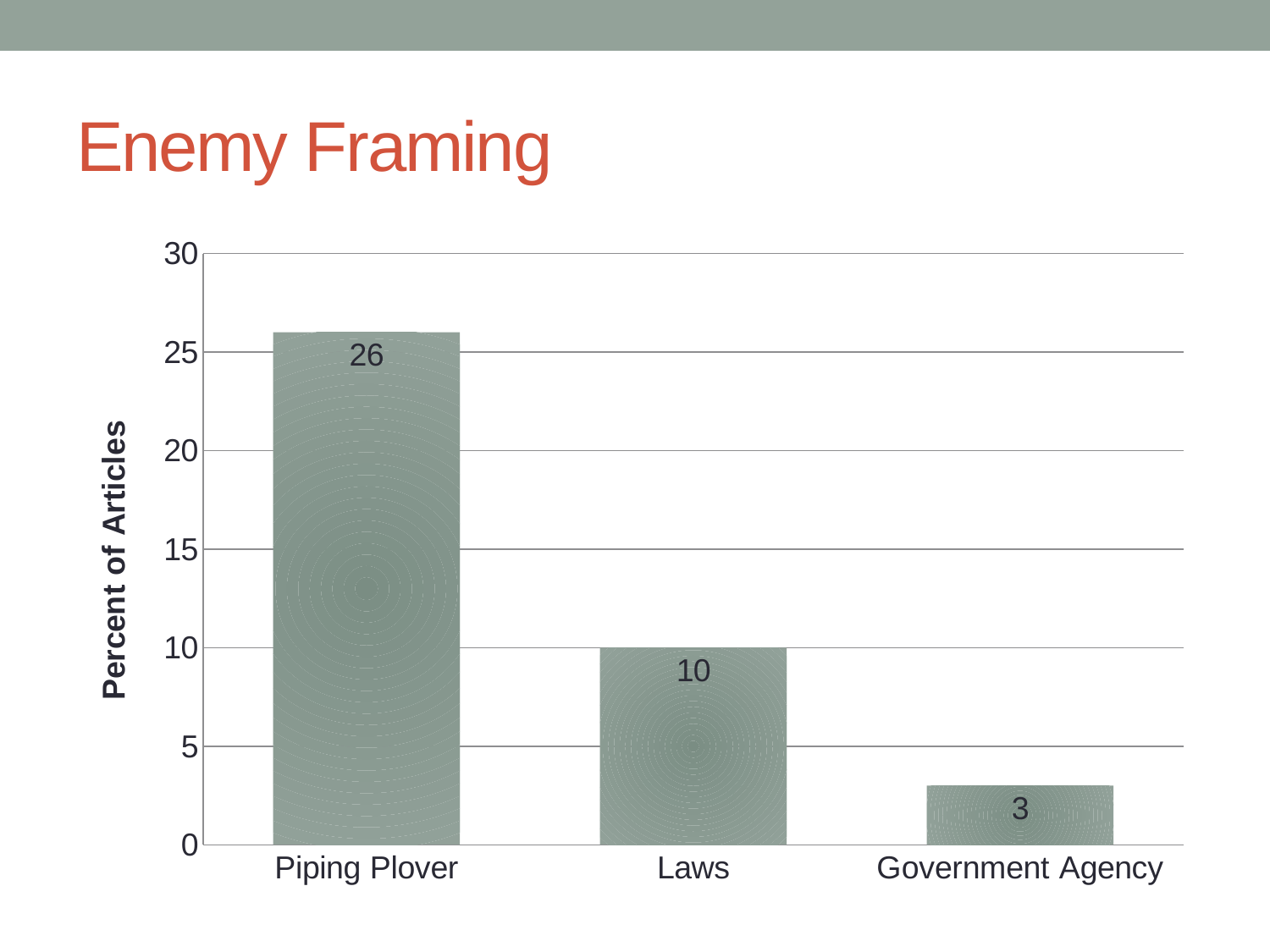
Which category has the highest percent of articles? Piping Plover What is the value for Government Agency? 3 What kind of chart is shown on the slide? bar chart Which category has the lowest percent of articles? Government Agency Is the value for Piping Plover greater or less than 20? greater How many categories are shown on the x axis? 3 What is the difference between the values for Laws and Government Agency? 7 What is the difference between the values for Piping Plover and Laws? 16 What is the value for Piping Plover? 26 What is the value for Laws? 10 Which is larger, the value for Laws or the value for Government Agency? Laws What is the label of the y axis? Percent of Articles